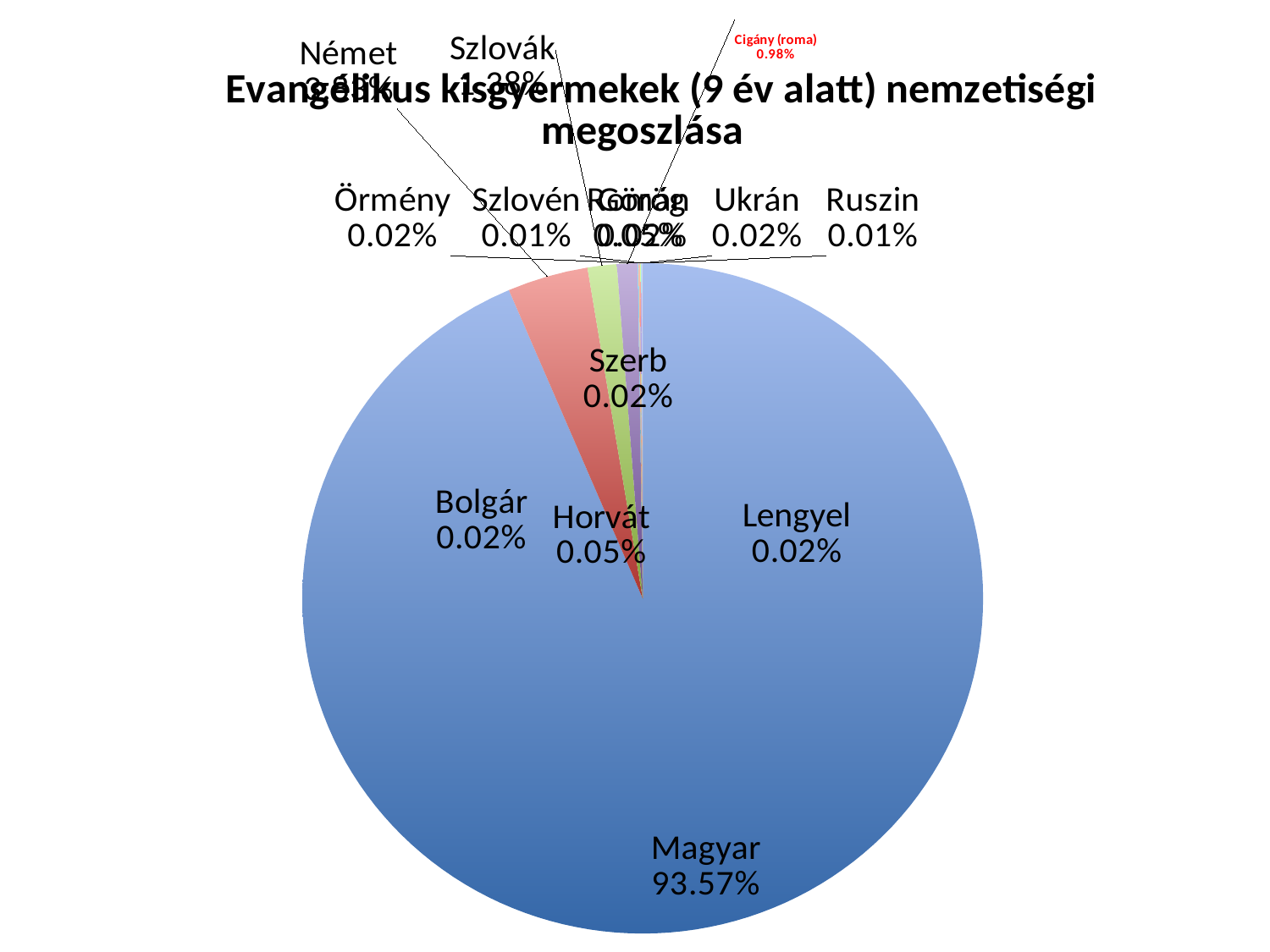
What is the value shown for Horvát? 0.05% What colour is the Magyar slice? blue What kind of chart is shown on the slide? pie chart What is the difference between the Szlovák share and the Cigány (roma) share? 0.40% What is the value shown for Ruszin? 0.01% What is the value shown for Ukrán? 0.02% Which category has the largest slice of the pie? Magyar Which is larger, the share for Szlovák or the share for Cigány (roma)? Szlovák What is the title of the chart? Evangélikus kisgyermekek (9 év alatt) nemzetiségi megoszlása What share of the pie does Magyar have? 93.57% What is the value shown for Szlovák? 1.38% What is the value shown for Cigány (roma)? 0.98%